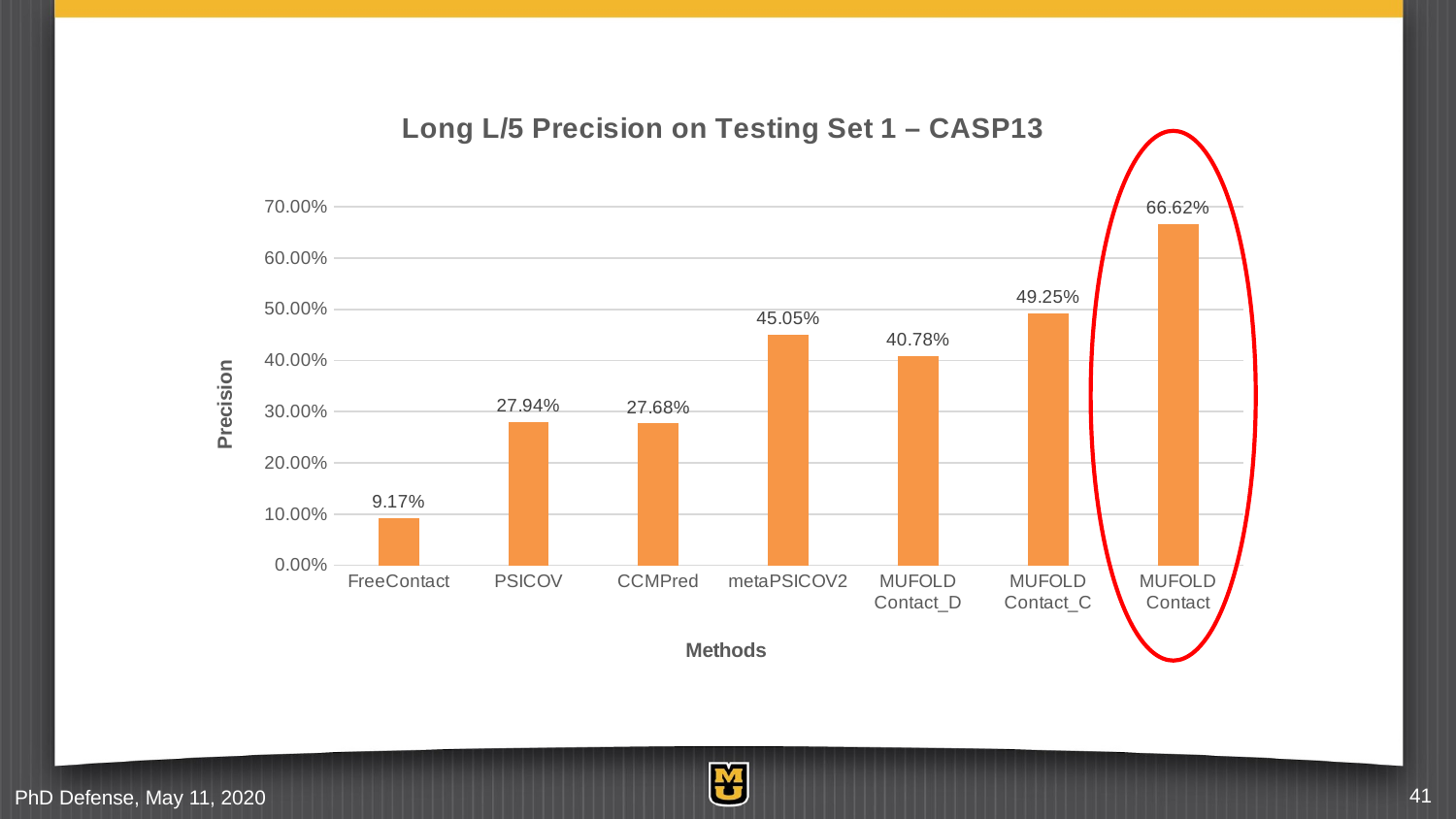
What is the title of the chart? Long L/5 Precision on Testing Set 1 – CASP13 What kind of chart is shown on the slide? bar chart What is the precision value for MUFOLD Contact_C? 49.25% Is the precision for MUFOLD Contact_D greater or less than 50.00%? less Which method has the highest precision? MUFOLD Contact Which method has the lowest precision? FreeContact What is the precision value for metaPSICOV2? 45.05% How many methods are shown on the x axis? 7 What is the precision value for FreeContact? 9.17% What is the difference in precision between MUFOLD Contact and MUFOLD Contact_C? 17.37% Which has a higher precision, metaPSICOV2 or MUFOLD Contact_D? metaPSICOV2 What is the difference in precision between PSICOV and CCMPred? 0.26%